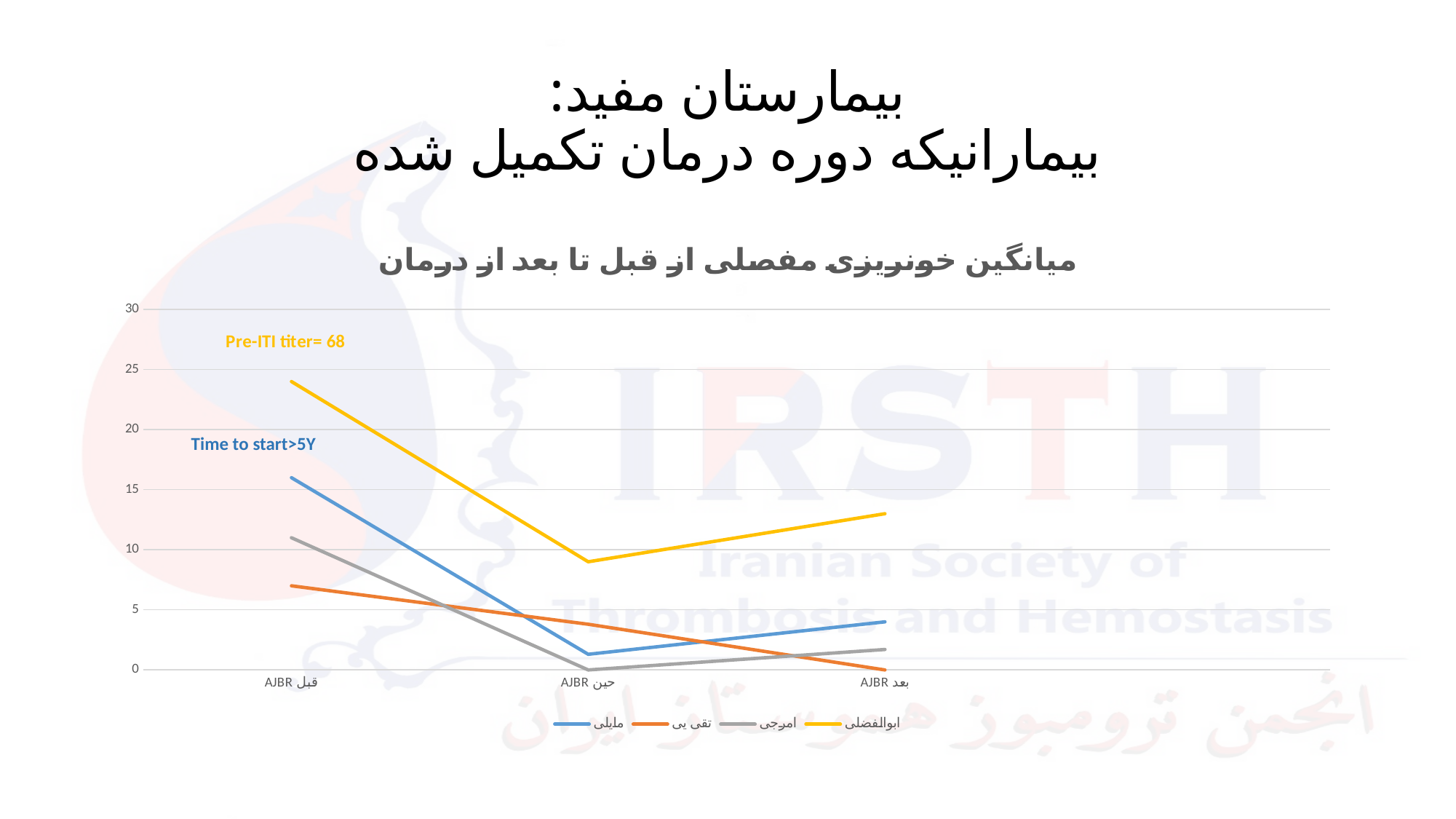
How many categories are shown on the x axis? 3 Is the value for مایلی at قبل AJBR greater or less than 10? greater Which series has the lowest value at قبل AJBR? تقی یی Which series has the lowest value at بعد AJBR? تقی یی What kind of chart is shown on the slide? line chart Is the value for ابوالفضلی at بعد AJBR greater or less than 10? greater Which series has the highest value at قبل AJBR? ابوالفضلی How many series does the legend list? 4 Does the value for ابوالفضلی rise or fall from قبل AJBR to حین AJBR? fall Is the value for ابوالفضلی at قبل AJBR greater or less than 20? greater What Pre-ITI titer value is annotated on the chart? 68 At بعد AJBR, which is larger: مایلی or امرجی? مایلی